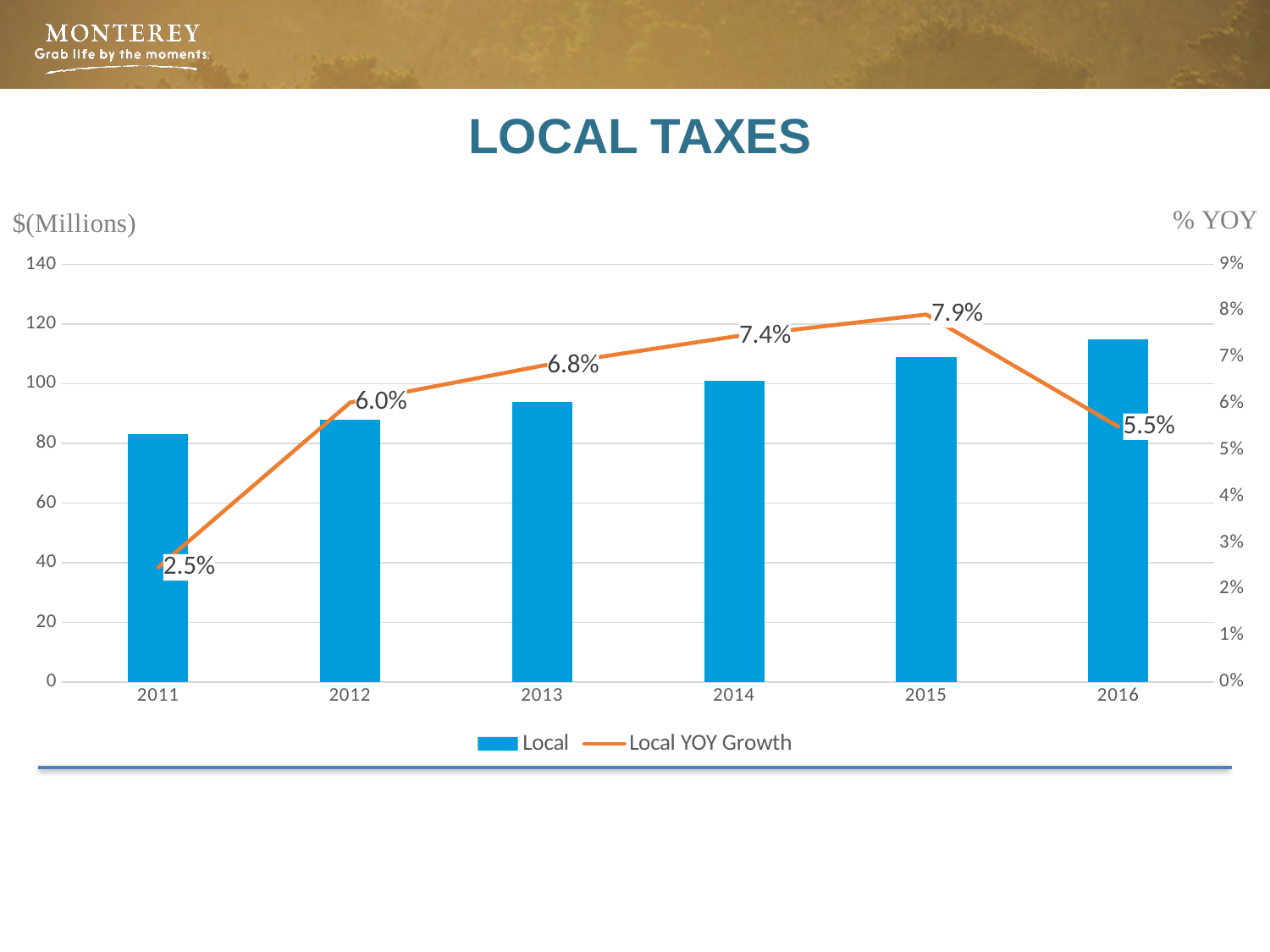
What is the difference between the Local YOY Growth values for 2015 and 2016? 2.4% How many series does the legend list? 2 What is the Local YOY Growth value for 2011? 2.5% How many years are shown on the x axis? 6 In which year is Local YOY Growth highest? 2015 What is the Local YOY Growth value for 2016? 5.5% Is the Local value for 2016 greater or less than 100? greater Is the Local value for 2011 greater or less than 100? less In which year is Local YOY Growth lowest? 2011 Which year has the larger Local YOY Growth, 2012 or 2013? 2013 Do the Local bar values rise or fall from 2011 to 2016? rise What is the Local YOY Growth value for 2014? 7.4%